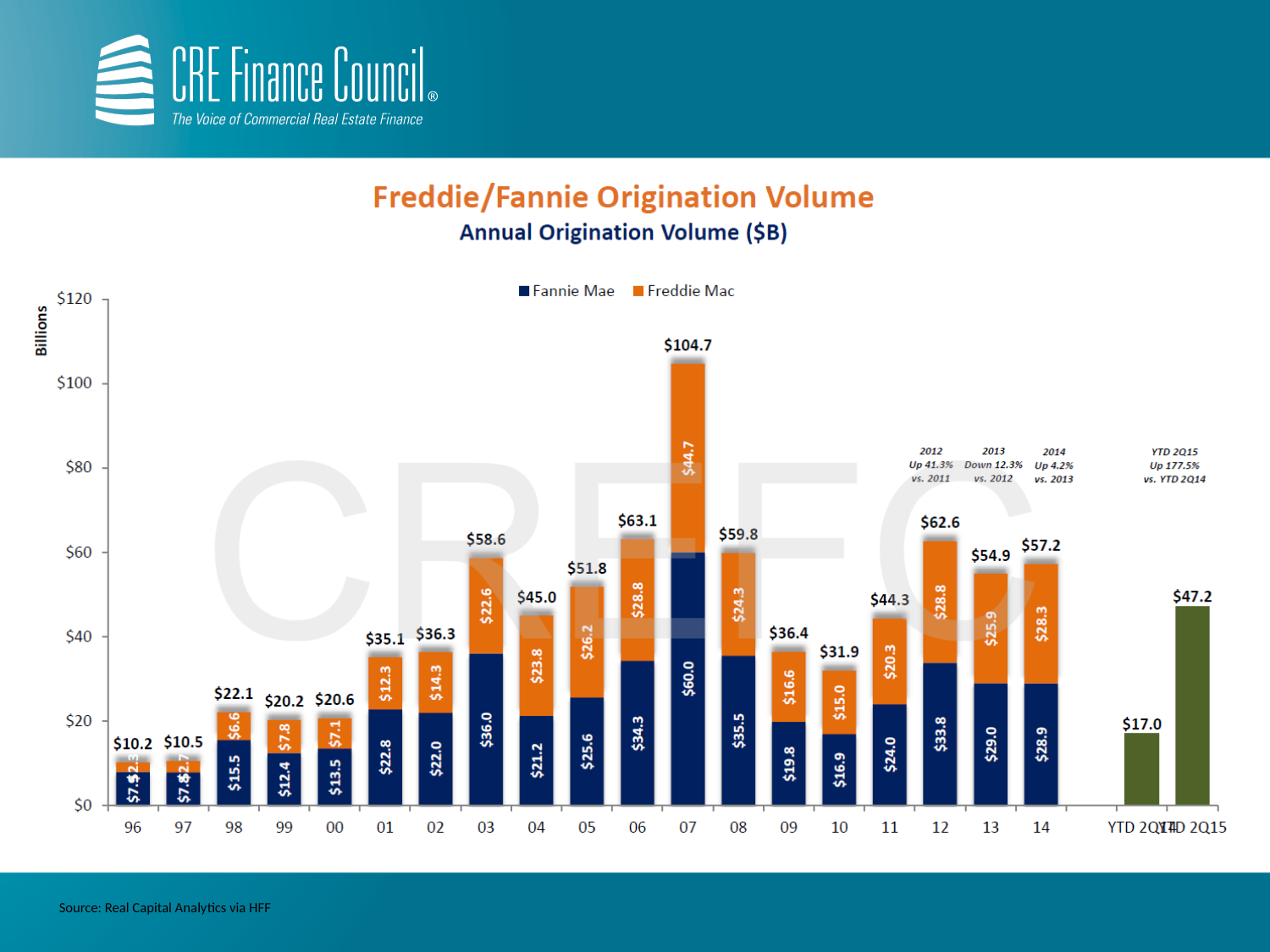
What is the total origination volume shown for YTD 2Q15? $47.2 What is the Fannie Mae origination volume shown for 2012? $33.8 Which year has the highest total annual origination volume? 07 Which year has the lowest total annual origination volume? 96 What is the total annual origination volume shown for 2007? $104.7 How many series does the legend list? 2 What is the Freddie Mac origination volume shown for 2006? $28.8 What colour represents Freddie Mac in the chart? Orange What kind of chart is shown on the slide? Stacked bar chart What is the difference between the YTD 2Q15 and YTD 2Q14 origination volumes? $30.2 What is the difference between the total origination volume in 2014 and in 2013? $2.3 Which is larger in 2004, the Fannie Mae volume or the Freddie Mac volume? Freddie Mac